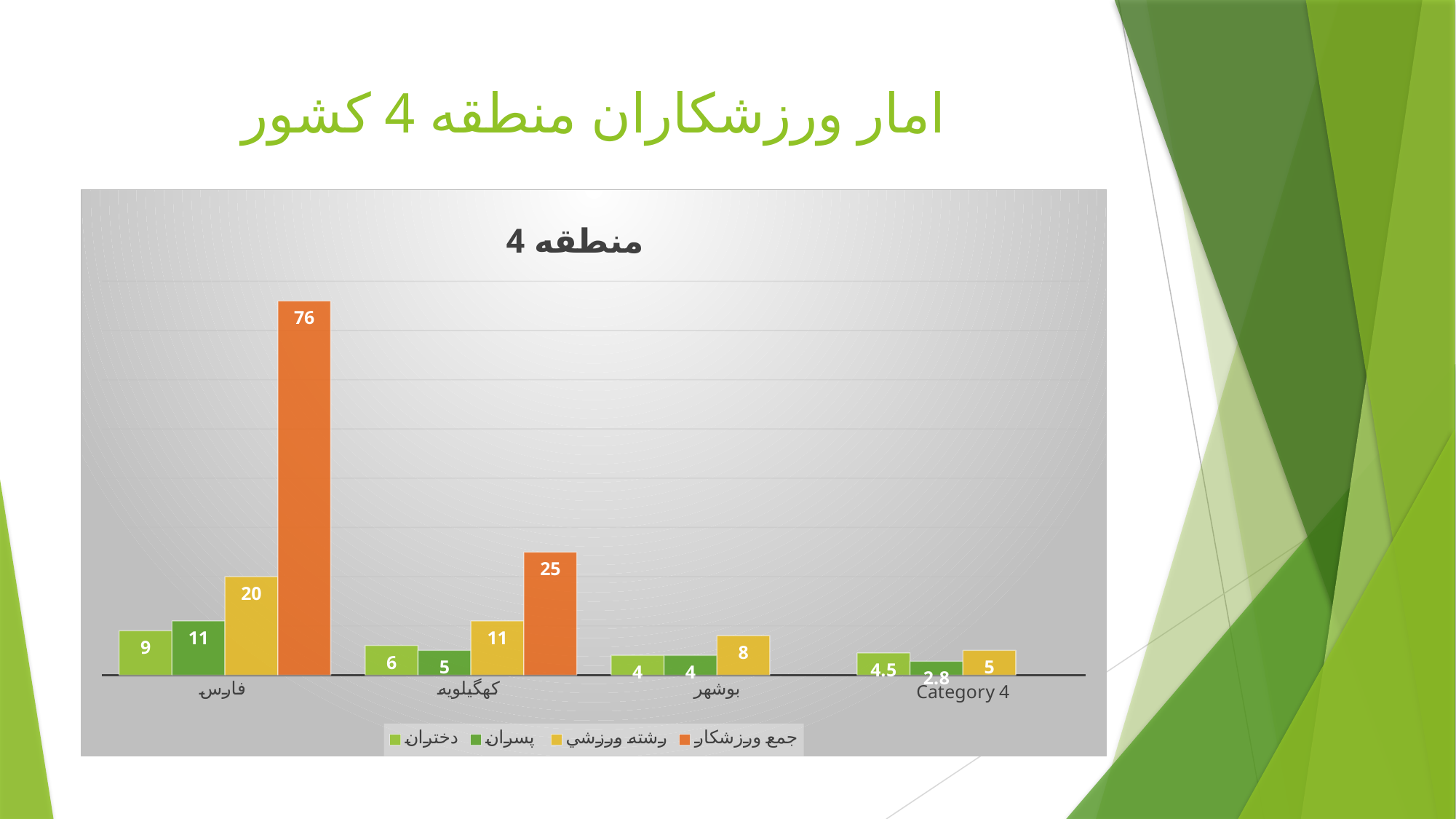
Which is larger: رشته ورزشی for فارس or رشته ورزشی for بوشهر? فارس What is the value of دختران for بوشهر? 4 Which category has the highest جمع ورزشکار value? فارس What is the value of جمع ورزشکار for فارس? 76 How many categories are shown on the x axis? 4 What is the value of پسران for Category 4? 2.8 What type of chart is shown on the slide? bar chart How many series does the legend list? 4 What is the value of رشته ورزشی for کهگیلویه? 11 What is the title of the chart? منطقه 4 What is the difference between the جمع ورزشکار values for فارس and کهگیلویه? 51 Which category has the lowest پسران value? Category 4